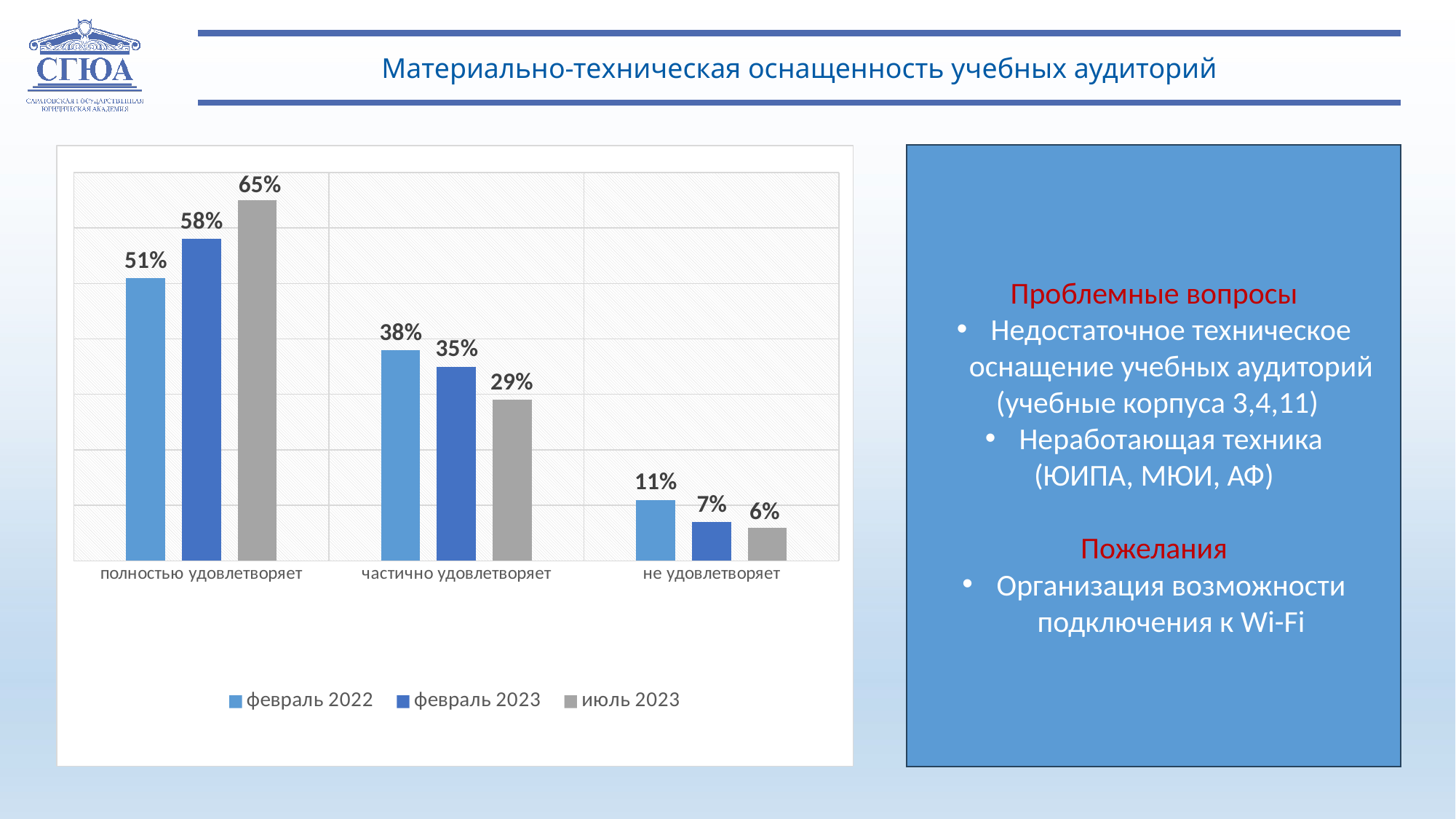
What is the value for 'частично удовлетворяет' in the 'февраль 2022' series? 38% What is the difference between the 'июль 2023' and 'февраль 2022' values for 'полностью удовлетворяет'? 14% What kind of chart is shown on the slide? bar chart What is the value for 'не удовлетворяет' in the 'февраль 2023' series? 7% What colour are the bars for the 'июль 2023' series? grey How many series does the legend list? 3 How many categories are shown on the x axis? 3 Do the values for 'полностью удовлетворяет' rise or fall from 'февраль 2022' to 'июль 2023'? rise Which category has the lowest value in the 'июль 2023' series? не удовлетворяет What is the value for 'полностью удовлетворяет' in the 'июль 2023' series? 65% Which is larger for 'частично удовлетворяет': the 'февраль 2023' value or the 'июль 2023' value? февраль 2023 Which category has the highest value in the 'февраль 2022' series? полностью удовлетворяет